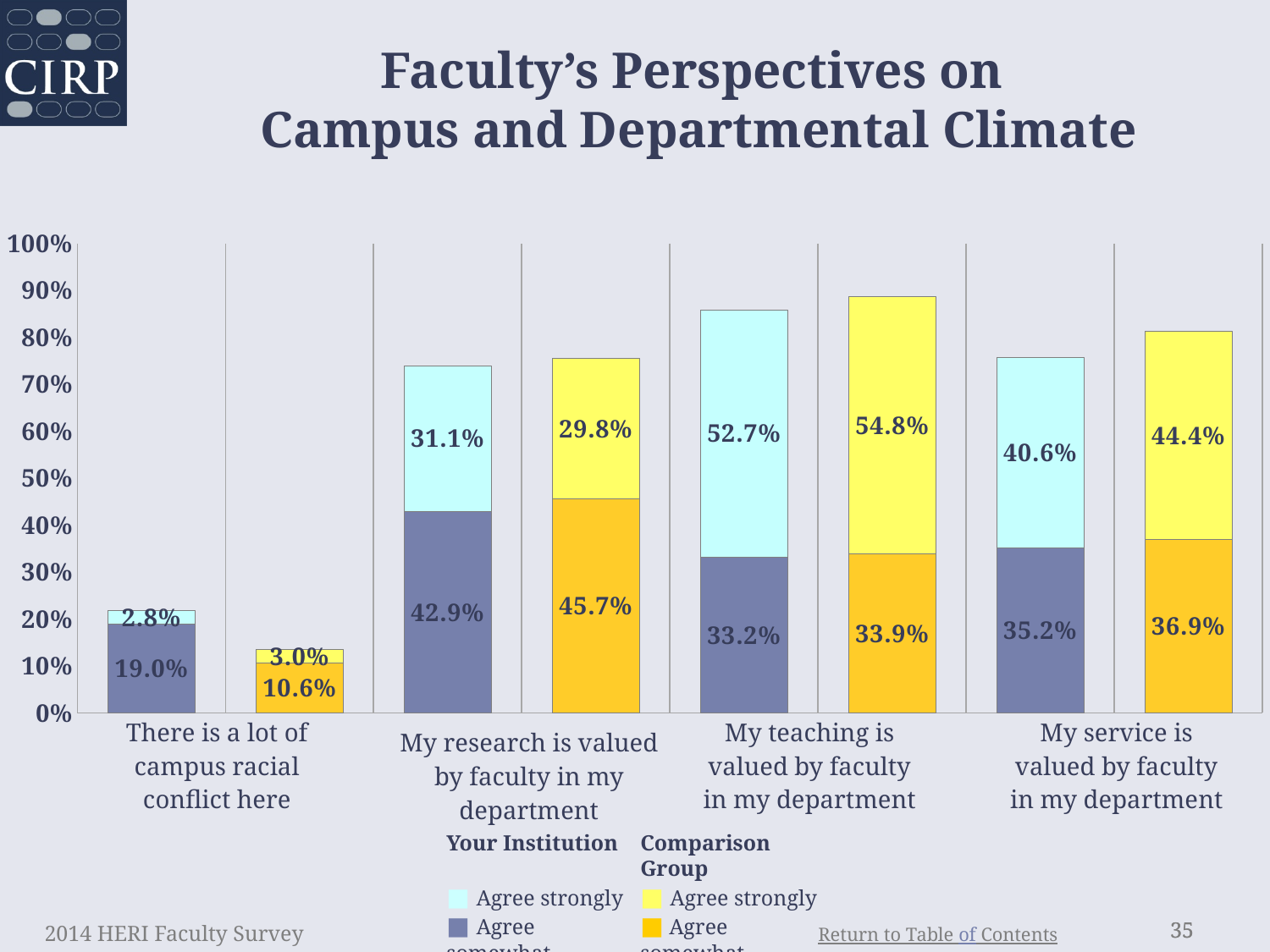
Which statement has the highest 'Agree strongly' value for the Comparison Group? My teaching is valued by faculty in my department What percentage of the Comparison Group agree somewhat that their research is valued by faculty in their department? 45.7% What type of chart is shown on the slide? Stacked bar chart What percentage of faculty at Your Institution agree strongly that their teaching is valued by faculty in their department? 52.7% What is the difference between the Comparison Group and Your Institution 'Agree strongly' values for 'My service is valued by faculty in my department'? 3.8% How many statements (categories) are shown on the x axis of the chart? 4 What percentage of faculty at Your Institution agree somewhat that there is a lot of campus racial conflict? 19.0% Which statement has the lowest 'Agree strongly' value for Your Institution? There is a lot of campus racial conflict here Is the total stacked bar for Your Institution on 'My teaching is valued by faculty in my department' greater or less than 80%? greater What is the total percentage of the Comparison Group who agree (somewhat or strongly) that their service is valued by faculty in their department? 81.3% What is the total percentage of faculty at Your Institution who agree (somewhat or strongly) that there is a lot of campus racial conflict? 21.8% For 'My research is valued by faculty in my department', is the 'Agree somewhat' value larger for Your Institution or the Comparison Group? Comparison Group